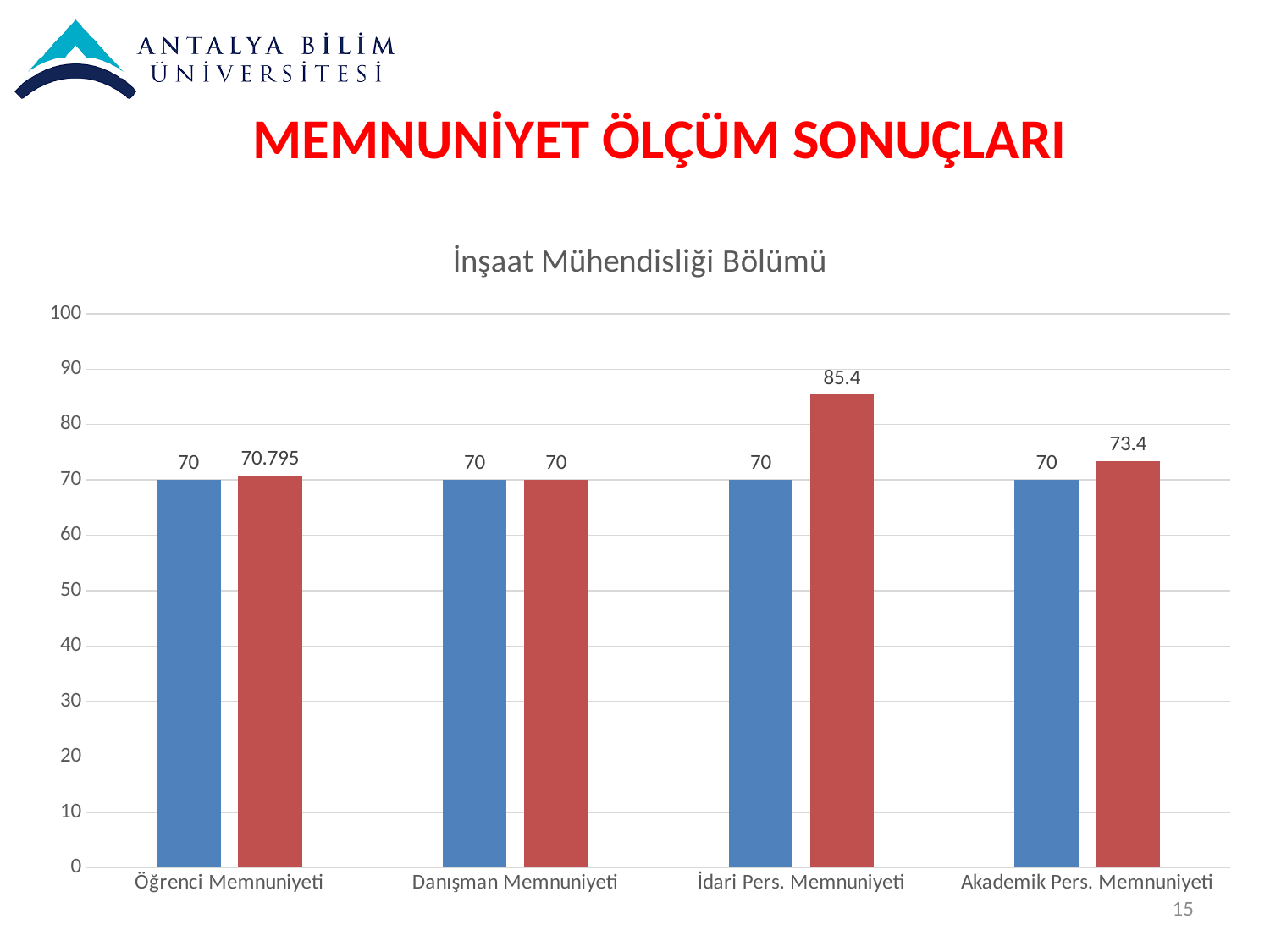
What is the value of the red bar for İdari Pers. Memnuniyeti? 85.4 What is the value of the red bar for Öğrenci Memnuniyeti? 70.795 What kind of chart is shown on the slide? bar chart How many categories are shown on the x axis? 4 Which is larger, the red bar for İdari Pers. Memnuniyeti or the red bar for Akademik Pers. Memnuniyeti? İdari Pers. Memnuniyeti Is the red bar for İdari Pers. Memnuniyeti greater or less than 80? greater What is the title of the chart? İnşaat Mühendisliği Bölümü What is the difference between the red bar and the blue bar for Akademik Pers. Memnuniyeti? 3.4 Which category has the highest red bar? İdari Pers. Memnuniyeti What is the difference between the red bar and the blue bar for İdari Pers. Memnuniyeti? 15.4 What is the value of the blue bar for Danışman Memnuniyeti? 70 What is the value of the red bar for Akademik Pers. Memnuniyeti? 73.4